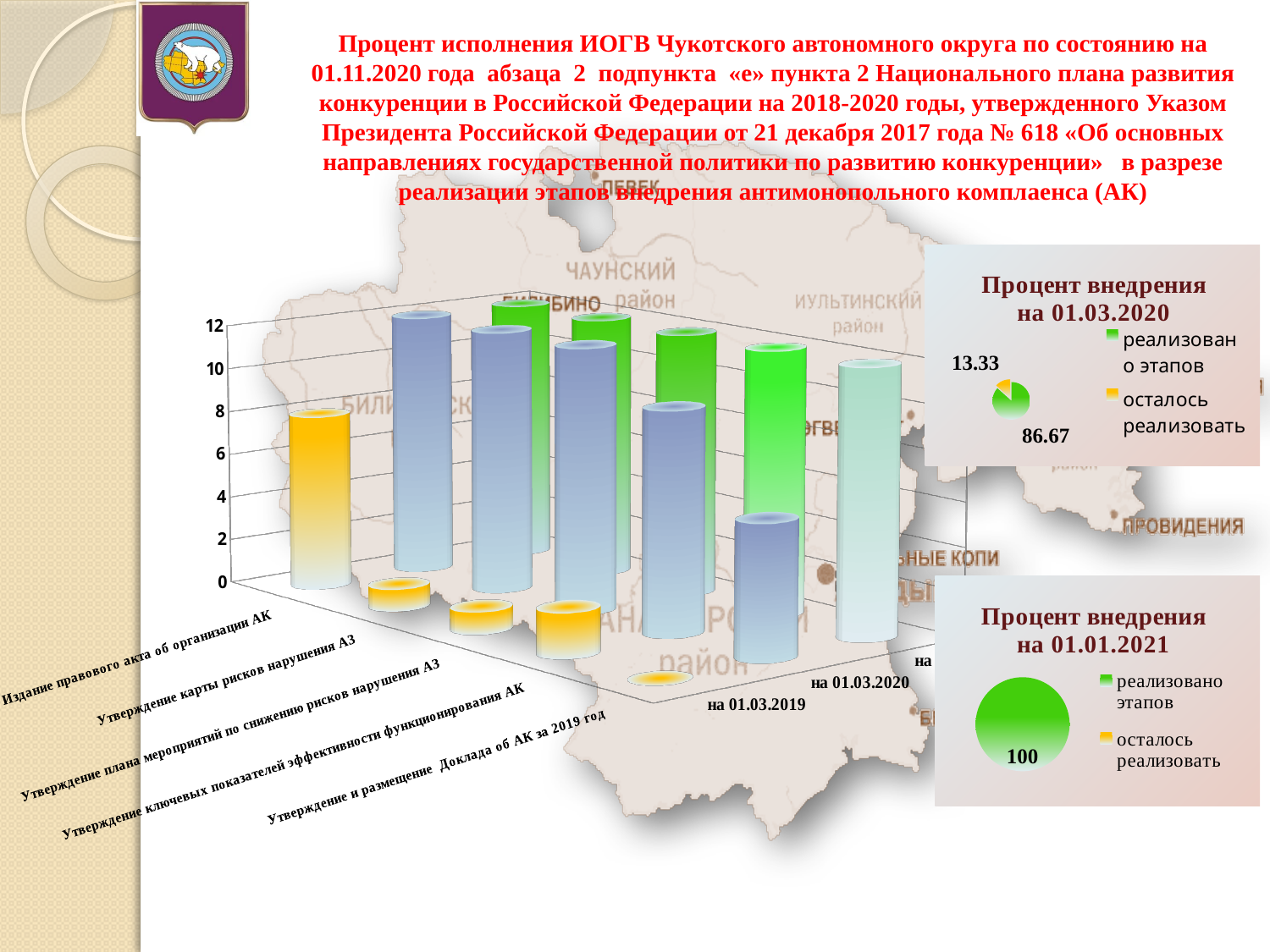
In the pie chart titled 'Процент внедрения на 01.03.2020', what value is shown for 'осталось реализовать'? 13.33 In the bar chart on the left, is the value for 'Утверждение карты рисков нарушения АЗ' on 01.03.2019 greater or less than 2? less In the bar chart on the left, is the value for 'Издание правового акта об организации АК' on 01.03.2019 greater or less than 4? greater How many entries does the legend of the pie chart titled 'Процент внедрения на 01.01.2021' list? 2 How many categories (stages) are shown along the category axis of the bar chart on the left? 5 In the pie chart titled 'Процент внедрения на 01.03.2020', what value is shown for 'реализовано этапов'? 86.67 In the pie chart titled 'Процент внедрения на 01.01.2021', what value is shown on the pie? 100 In the pie chart titled 'Процент внедрения на 01.03.2020', what colour represents 'осталось реализовать'? yellow What kind of chart is the large chart on the left of the slide? bar chart What kind of chart is the chart titled 'Процент внедрения на 01.01.2021'? pie chart In the pie chart titled 'Процент внедрения на 01.03.2020', which slice is larger: 'реализовано этапов' or 'осталось реализовать'? реализовано этапов In the pie chart titled 'Процент внедрения на 01.03.2020', what is the difference between the 'реализовано этапов' and 'осталось реализовать' values? 73.34